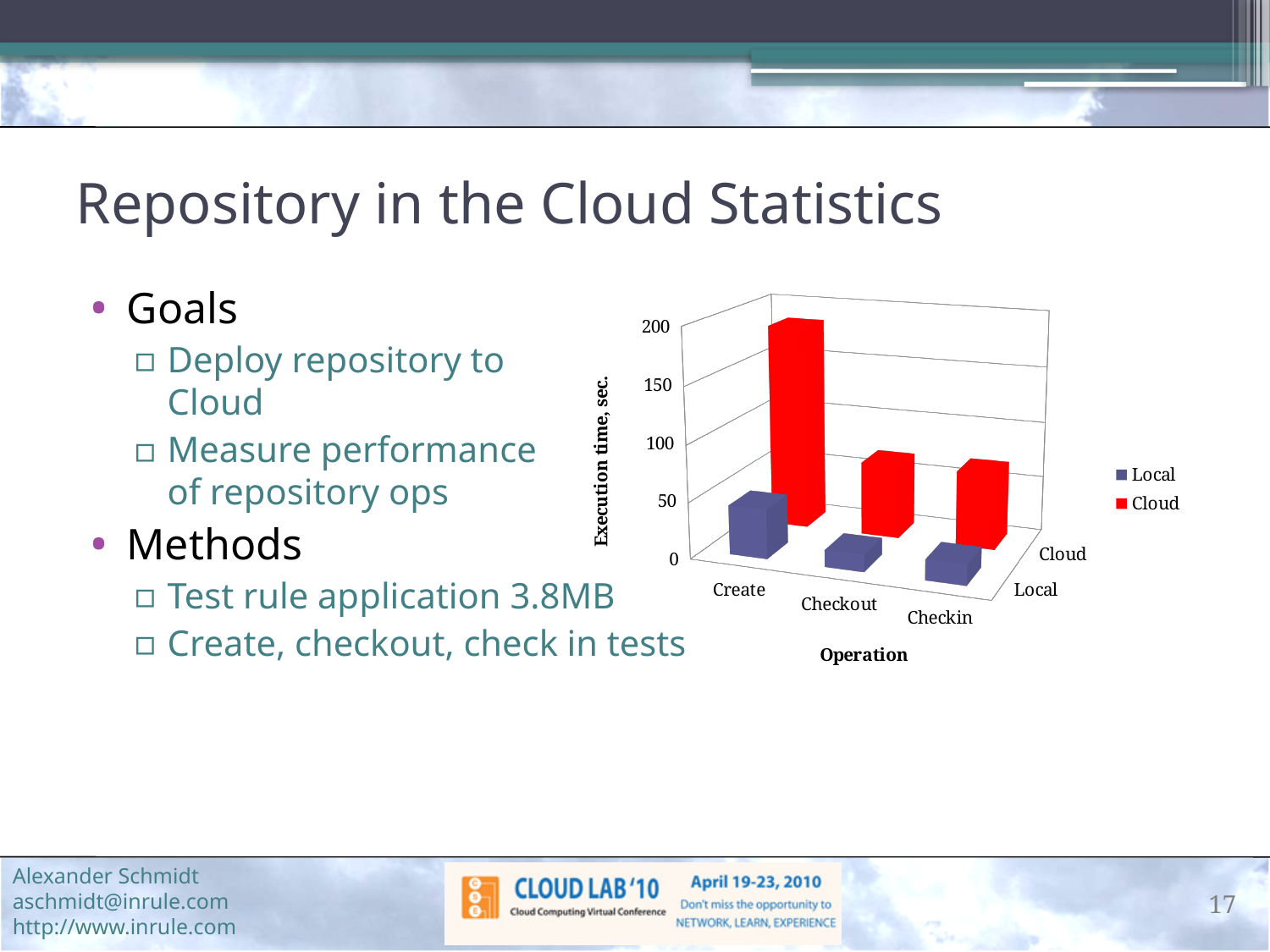
Is the Local execution time for Checkout greater or less than 50? less Which operation has the highest execution time for the Cloud series? Create Is the Cloud execution time for Create greater or less than 150? greater What colour are the Cloud bars in the chart? red How many operations are shown on the x axis of the chart? 3 Which operation has the highest execution time for the Local series? Create What is the title of the vertical axis of the chart? Execution time, sec. For the Checkin operation, which series has the larger execution time, Local or Cloud? Cloud What kind of chart is shown on the slide? bar chart Is the Cloud execution time for Checkout greater or less than 150? less For the Create operation, which series has the larger execution time, Local or Cloud? Cloud How many series does the chart legend list? 2